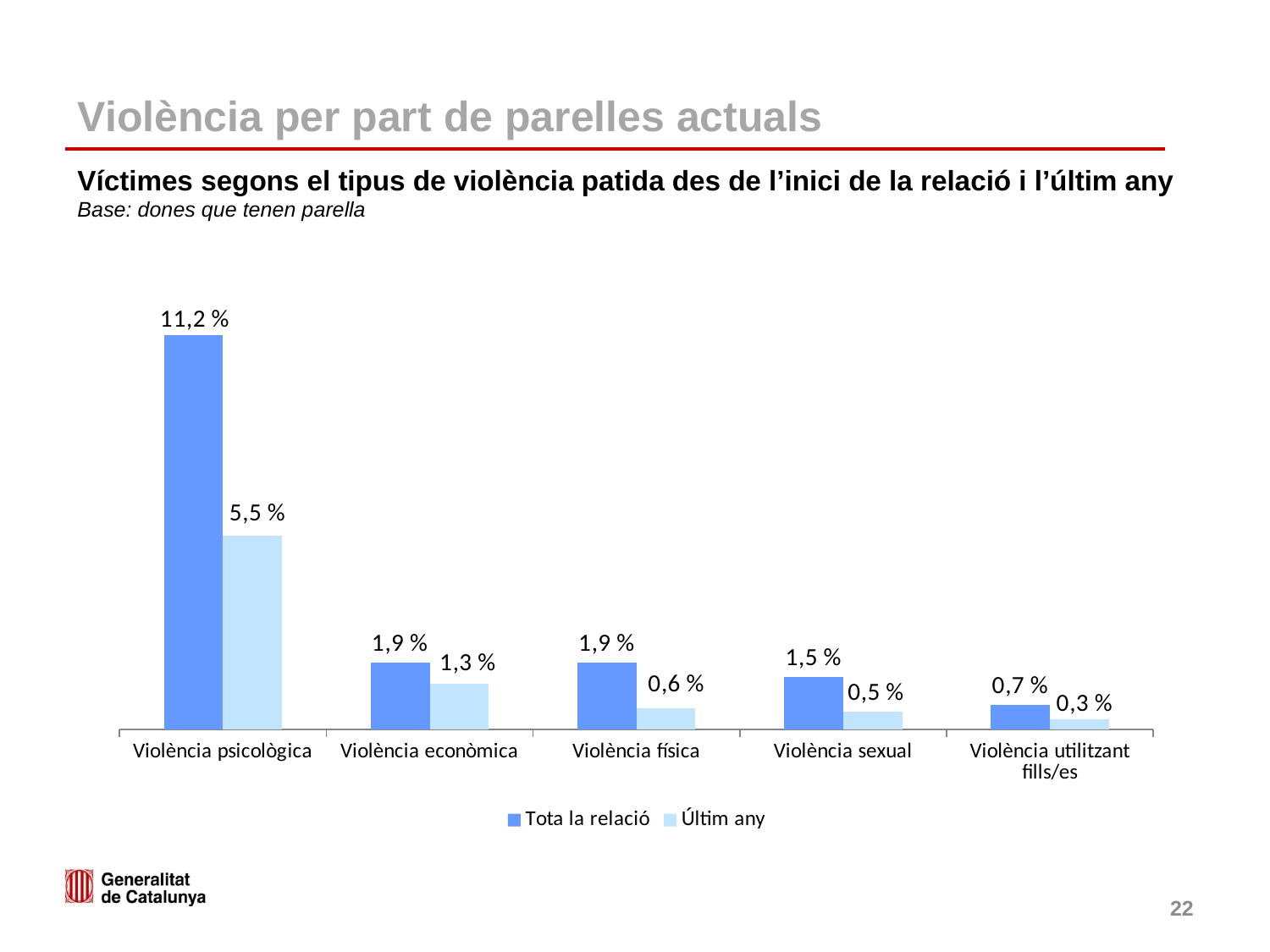
What are the two series named in the legend? Tota la relació and Últim any How many categories are shown on the x axis? 5 What kind of chart is shown on the slide? Bar chart Which is larger: 'Últim any' for 'Violència econòmica' or 'Últim any' for 'Violència física'? Violència econòmica What is the value for 'Últim any' in the 'Violència econòmica' category? 1,3 % What is the value for 'Últim any' in the 'Violència sexual' category? 0,5 % What is the difference between 'Tota la relació' and 'Últim any' for 'Violència psicològica'? 5,7 % Which category has the lowest value for 'Últim any'? Violència utilitzant fills/es Which category has the highest value for 'Tota la relació'? Violència psicològica How many series does the legend list? 2 What is the value for 'Tota la relació' in the 'Violència psicològica' category? 11,2 % Do the 'Tota la relació' values rise or fall from left to right along the x axis? Fall